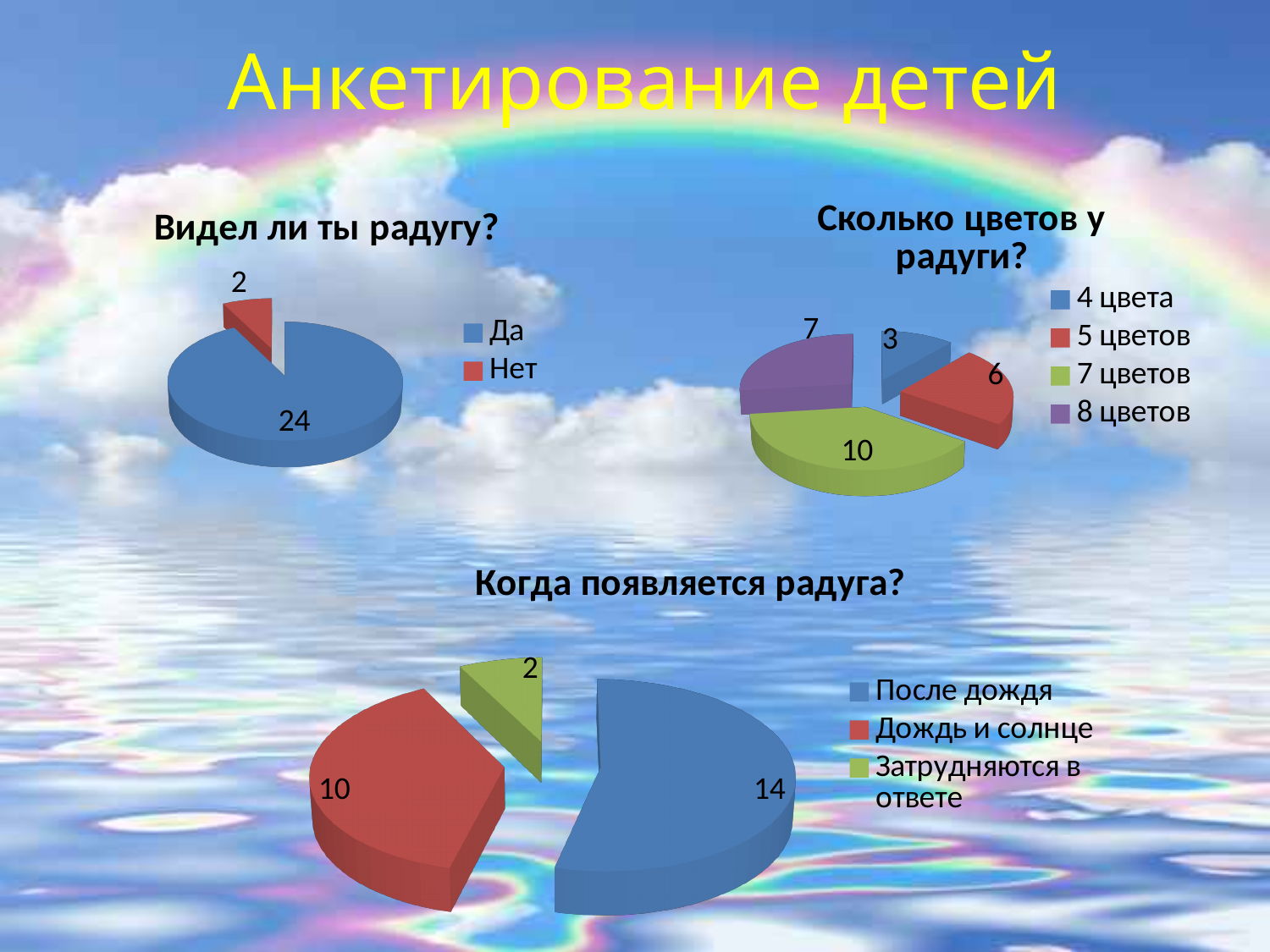
In the chart 'Сколько цветов у радуги?', what is the value for '7 цветов'? 10 In the chart 'Видел ли ты радугу?', how many children answered 'Да'? 24 In the chart 'Сколько цветов у радуги?', which answer has the highest value? 7 цветов In the chart 'Сколько цветов у радуги?', which answer has the lowest value? 4 цвета In the chart 'Когда появляется радуга?', which is larger: 'После дождя' or 'Дождь и солнце'? После дождя In the chart 'Сколько цветов у радуги?', what is the total of all slices? 26 What type of chart is 'Когда появляется радуга?'? Pie chart In the chart 'Когда появляется радуга?', what colour is the 'Затрудняются в ответе' slice? Green In the chart 'Сколько цветов у радуги?', how many categories does the legend list? 4 In the chart 'Видел ли ты радугу?', what is the difference between the 'Да' and 'Нет' values? 22 In the chart 'Когда появляется радуга?', what is the value for 'Дождь и солнце'? 10 In the chart 'Видел ли ты радугу?', how many children answered 'Нет'? 2